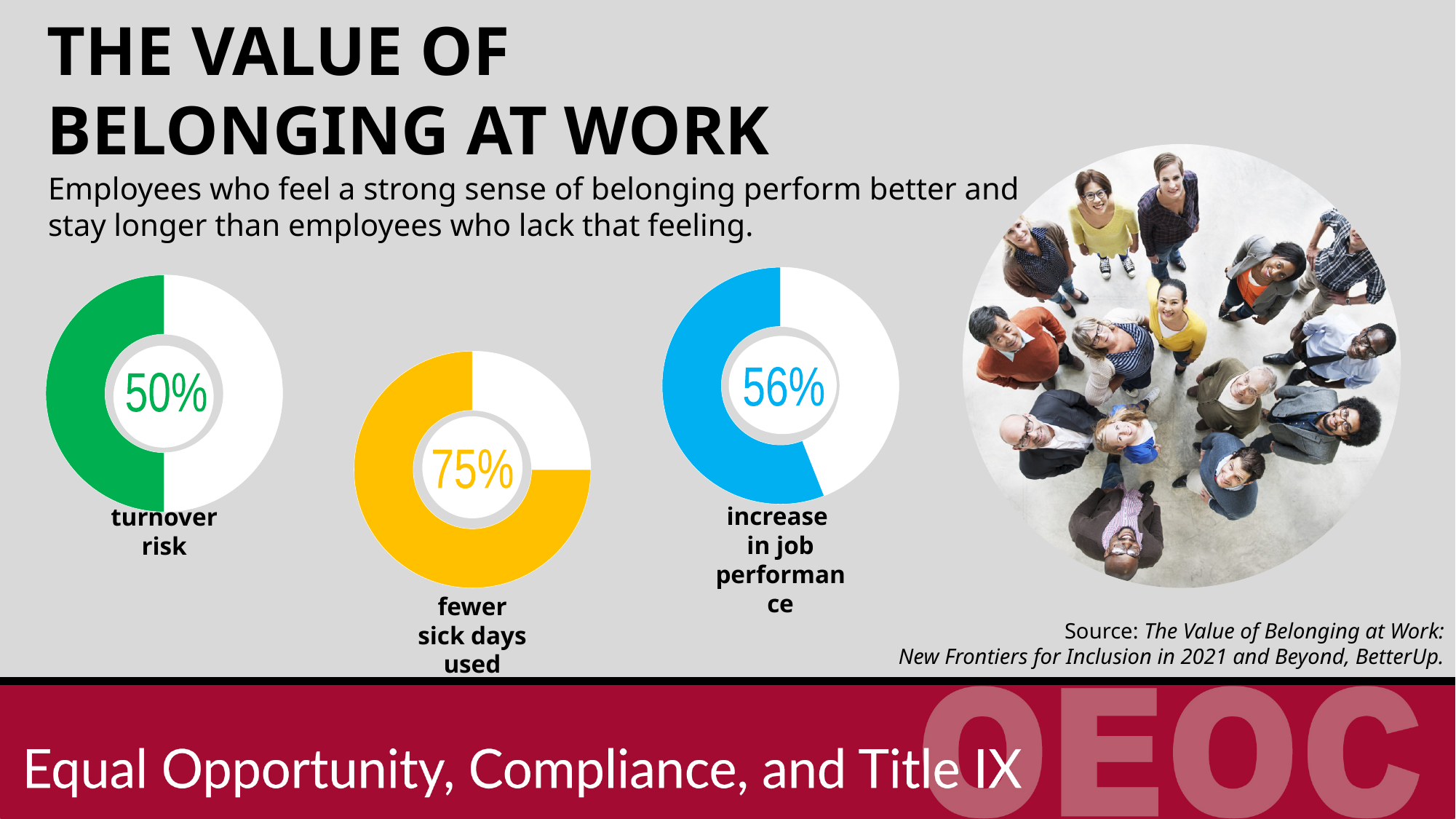
What value is shown in the 'turnover risk' donut chart? 50% What colour is the filled portion of the 'increase in job performance' donut chart? blue What colour is the filled portion of the 'fewer sick days used' donut chart? yellow Which of the three donut charts shows the lowest percentage? turnover risk What value is shown in the 'fewer sick days used' donut chart? 75% What kind of chart is used to show the 'turnover risk' value? donut chart Which is larger: the 'increase in job performance' value or the 'turnover risk' value? increase in job performance What value is shown in the 'increase in job performance' donut chart? 56% Which of the three donut charts shows the highest percentage? fewer sick days used How many donut charts are shown on the slide? 3 What is the difference between the 'increase in job performance' value and the 'turnover risk' value? 6% What is the difference between the 'fewer sick days used' value and the 'turnover risk' value? 25%